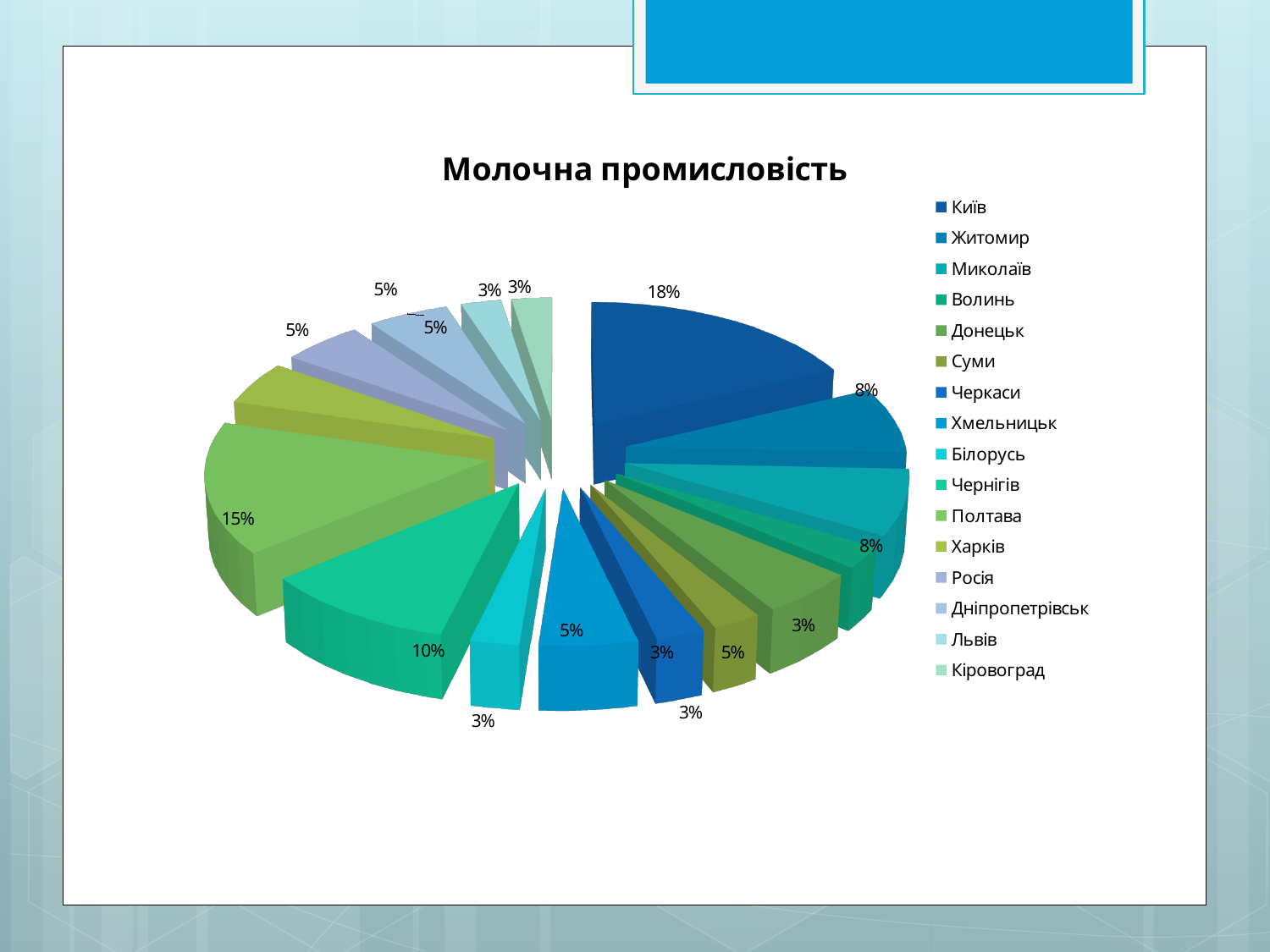
What share of the pie does Київ have? 18% Which is larger, the slice for Київ or the slice for Полтава? Київ What kind of chart is shown on the slide? pie chart What is the value shown for Житомир? 8% What is the value shown for Чернігів? 10% What is the title of the chart? Молочна промисловість What is the value shown for Кіровоград? 3% How many categories does the legend of the pie chart list? 16 Which category has the largest slice of the pie? Київ What share of the pie does Полтава have? 15% Which is larger, the slice for Чернігів or the slice for Житомир? Чернігів What is the difference between the shares of Київ and Полтава? 3 percentage points